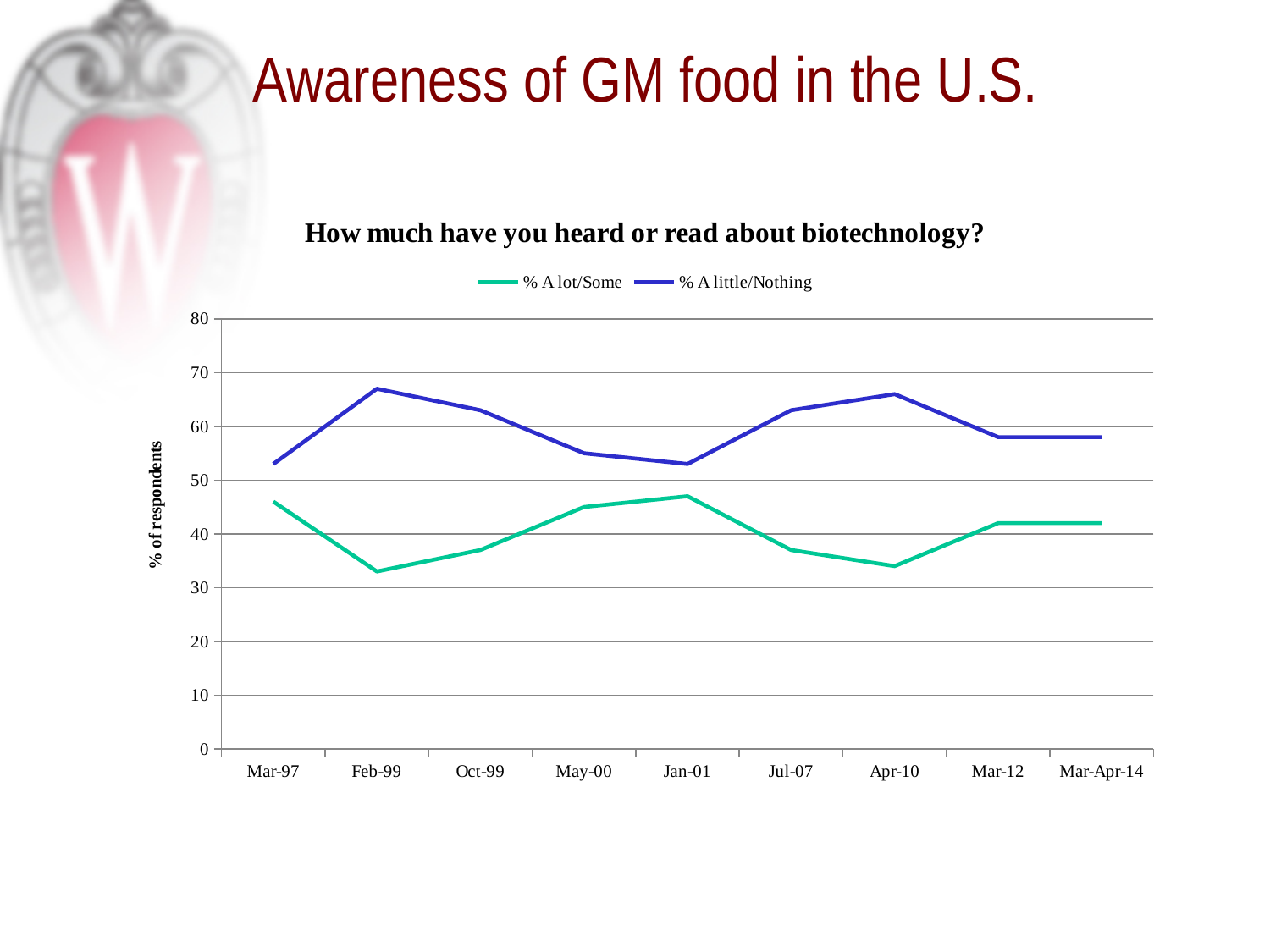
Is the value for % A little/Nothing at Apr-10 greater or less than 60? greater How many series does the legend list? 2 For % A lot/Some, which is larger, the value at Feb-99 or the value at Jan-01? Jan-01 Is the value for % A lot/Some at Jan-01 greater or less than 40? greater At Mar-97, which series has the larger value, % A lot/Some or % A little/Nothing? % A little/Nothing What kind of chart is shown on the slide? line chart Is the value for % A little/Nothing at Feb-99 greater or less than 60? greater What is the title of the chart? How much have you heard or read about biotechnology? How many time points are plotted along the x axis? 9 Does the % A lot/Some line rise or fall from Feb-99 to Jan-01? rise What is the label on the vertical axis? % of respondents